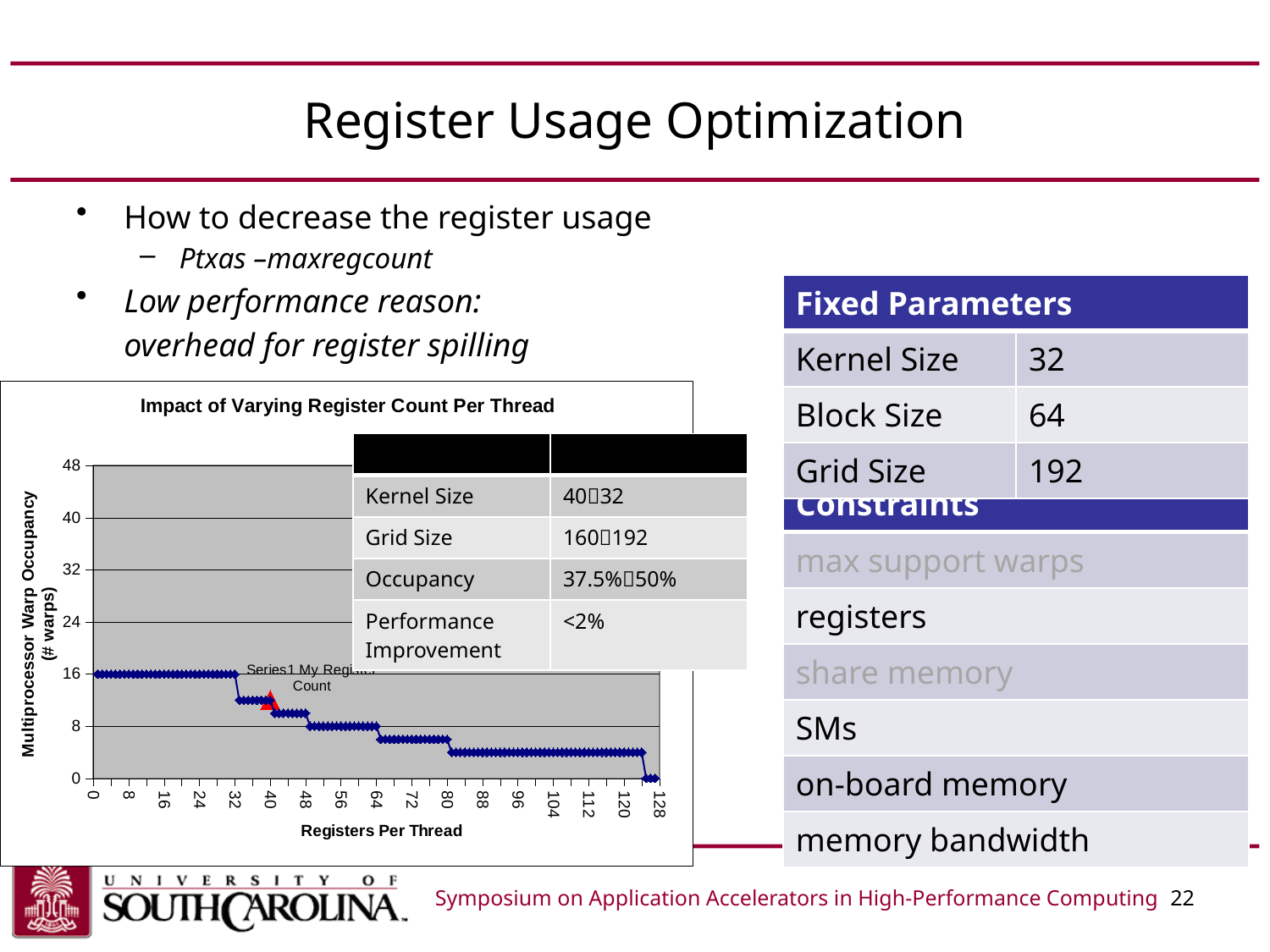
As registers per thread increase along the x axis, does multiprocessor warp occupancy rise or fall? fall Which has the lower warp occupancy: 40 registers per thread or 88 registers per thread? 88 registers per thread What kind of chart is shown on the slide? line chart What is the multiprocessor warp occupancy at 16 registers per thread? 16 Is the warp occupancy at 24 registers per thread greater or less than 24? less Is the warp occupancy at 8 registers per thread greater or less than 8? greater Which has the higher warp occupancy: 8 registers per thread or 120 registers per thread? 8 registers per thread What is the label of the x axis of the chart? Registers Per Thread Is the warp occupancy at 104 registers per thread greater or less than 8? less What is the multiprocessor warp occupancy at 56 registers per thread? 8 What is the title of the chart? Impact of Varying Register Count Per Thread